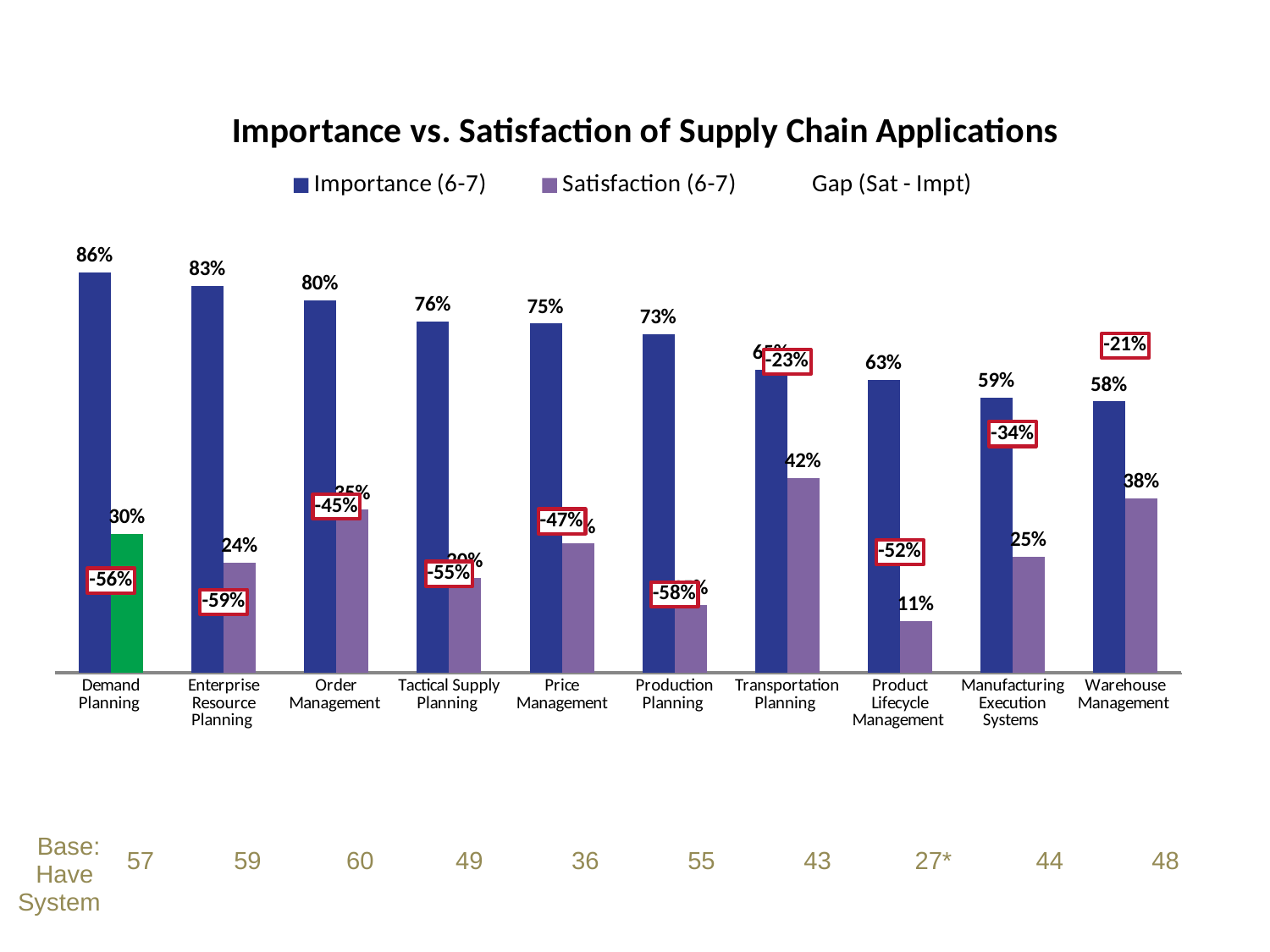
Which category has the lowest Satisfaction (6-7) value? Product Lifecycle Management What is the difference between the Importance (6-7) and Satisfaction (6-7) values for Enterprise Resource Planning? 59 percentage points What is the Satisfaction (6-7) value for Transportation Planning? 42% What is the Gap (Sat - Impt) value for Enterprise Resource Planning? -59% What is the Importance (6-7) value for Demand Planning? 86% How many series does the legend list? 3 How many categories are shown on the x axis? 10 Which category has the highest Importance (6-7) value? Demand Planning What is the Satisfaction (6-7) value for Product Lifecycle Management? 11% Which category has the highest Satisfaction (6-7) value? Transportation Planning Which is larger, the Satisfaction (6-7) value for Transportation Planning or for Warehouse Management? Transportation Planning What kind of chart is shown on the slide? Bar chart